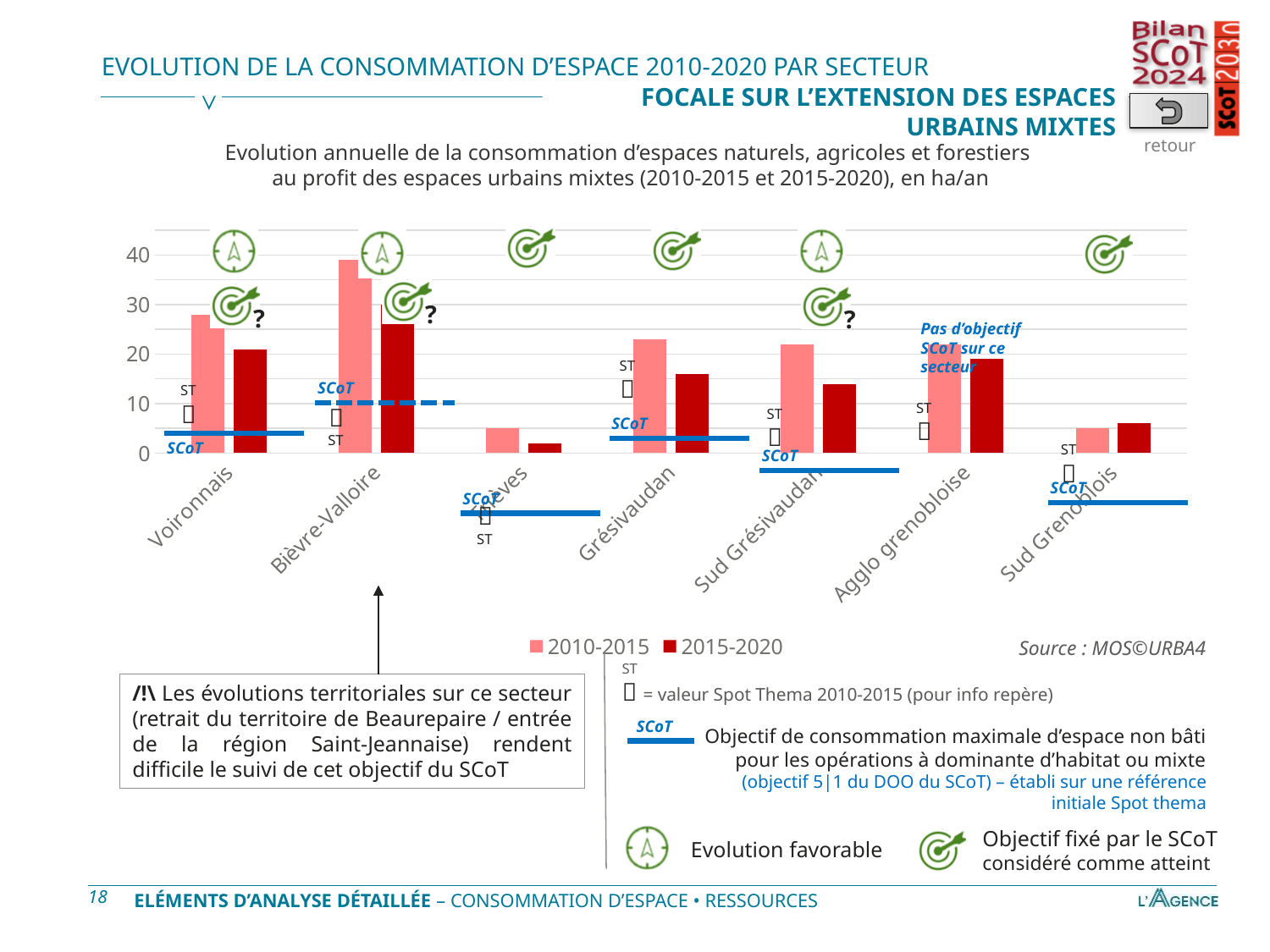
What source is cited for the chart data? MOS©URBA4 For Voironnais, which series has the larger value: 2010-2015 or 2015-2020? 2010-2015 How many sectors (categories) are shown on the x axis of the chart? 7 Is the 2010-2015 value for Trièves greater or less than 10? less Is the 2015-2020 value for Sud Grenoblois greater or less than 10? less What kind of chart is shown on the slide? bar chart Is the 2015-2020 value for Grésivaudan greater or less than 10? greater How many series does the chart legend list? 2 Which sector has the highest value for the 2010-2015 series? Bièvre-Valloire For Bièvre-Valloire, which series has the larger value: 2010-2015 or 2015-2020? 2010-2015 Which sector has the lowest value for the 2015-2020 series? Trièves